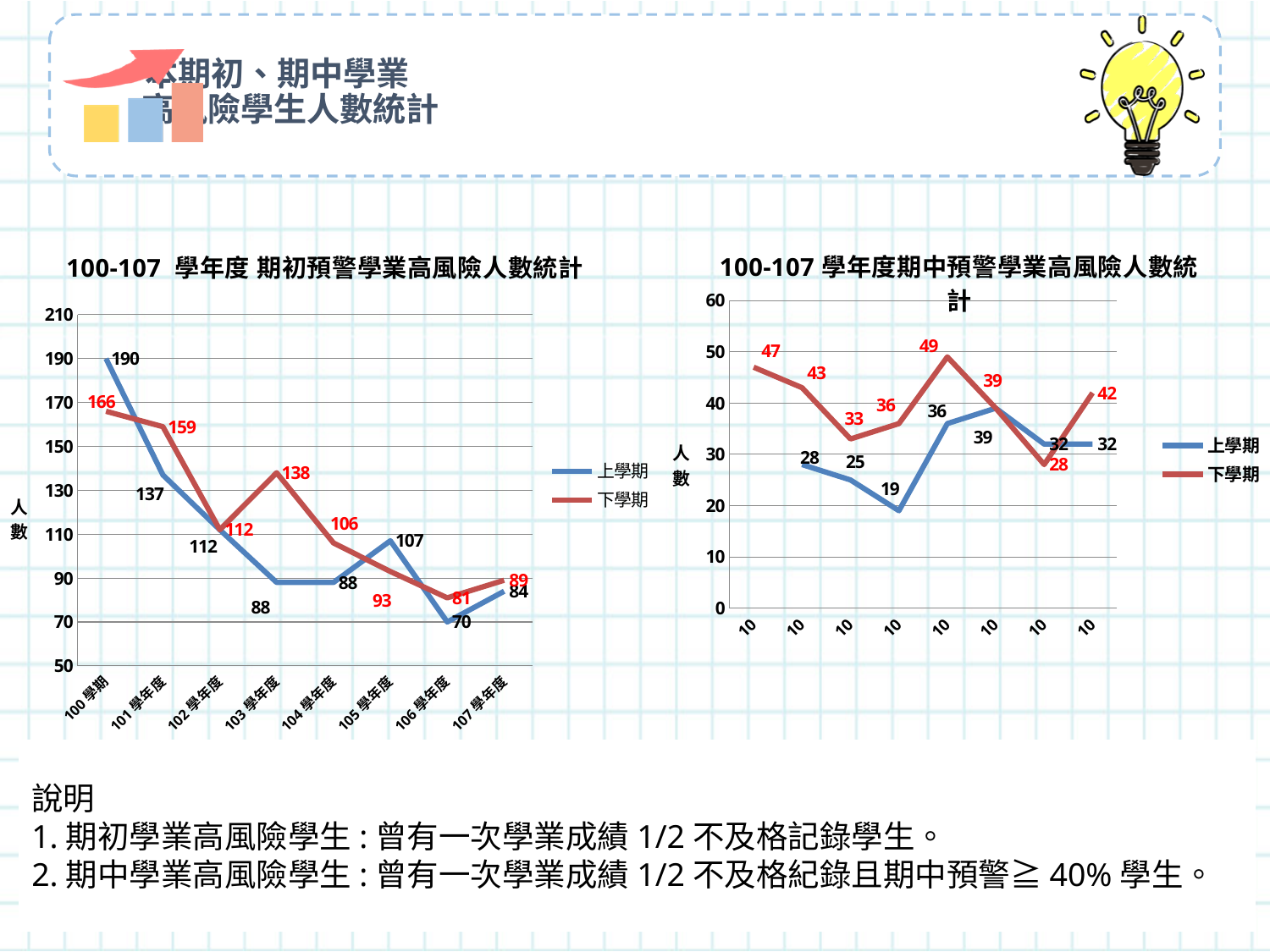
In the left chart (100-107 學年度 期初預警學業高風險人數統計), does the 上學期 series generally rise or fall from 100 學期 to 103 學年度? fall In the left chart (100-107 學年度 期初預警學業高風險人數統計), which category has the lowest 上學期 value? 106 學年度 In the left chart (100-107 學年度 期初預警學業高風險人數統計), which is larger for 105 學年度: 上學期 or 下學期? 上學期 In the right chart (100-107 學年度期中預警學業高風險人數統計), what is the lowest value of the 上學期 series? 19 In the left chart (100-107 學年度 期初預警學業高風險人數統計), which category has the highest 下學期 value? 100 學期 In the left chart (100-107 學年度 期初預警學業高風險人數統計), what is the value of 上學期 for 100 學期? 190 In the right chart (100-107 學年度期中預警學業高風險人數統計), what is the highest value of the 下學期 series? 49 In the left chart (100-107 學年度 期初預警學業高風險人數統計), how many categories are shown on the x axis? 8 How many series does the legend of the right chart (100-107 學年度期中預警學業高風險人數統計) list? 2 What type of chart is the right chart (100-107 學年度期中預警學業高風險人數統計)? line chart In the left chart (100-107 學年度 期初預警學業高風險人數統計), what is the value of 下學期 for 103 學年度? 138 In the left chart (100-107 學年度 期初預警學業高風險人數統計), what is the difference between the 上學期 and 下學期 values for 101 學年度? 22